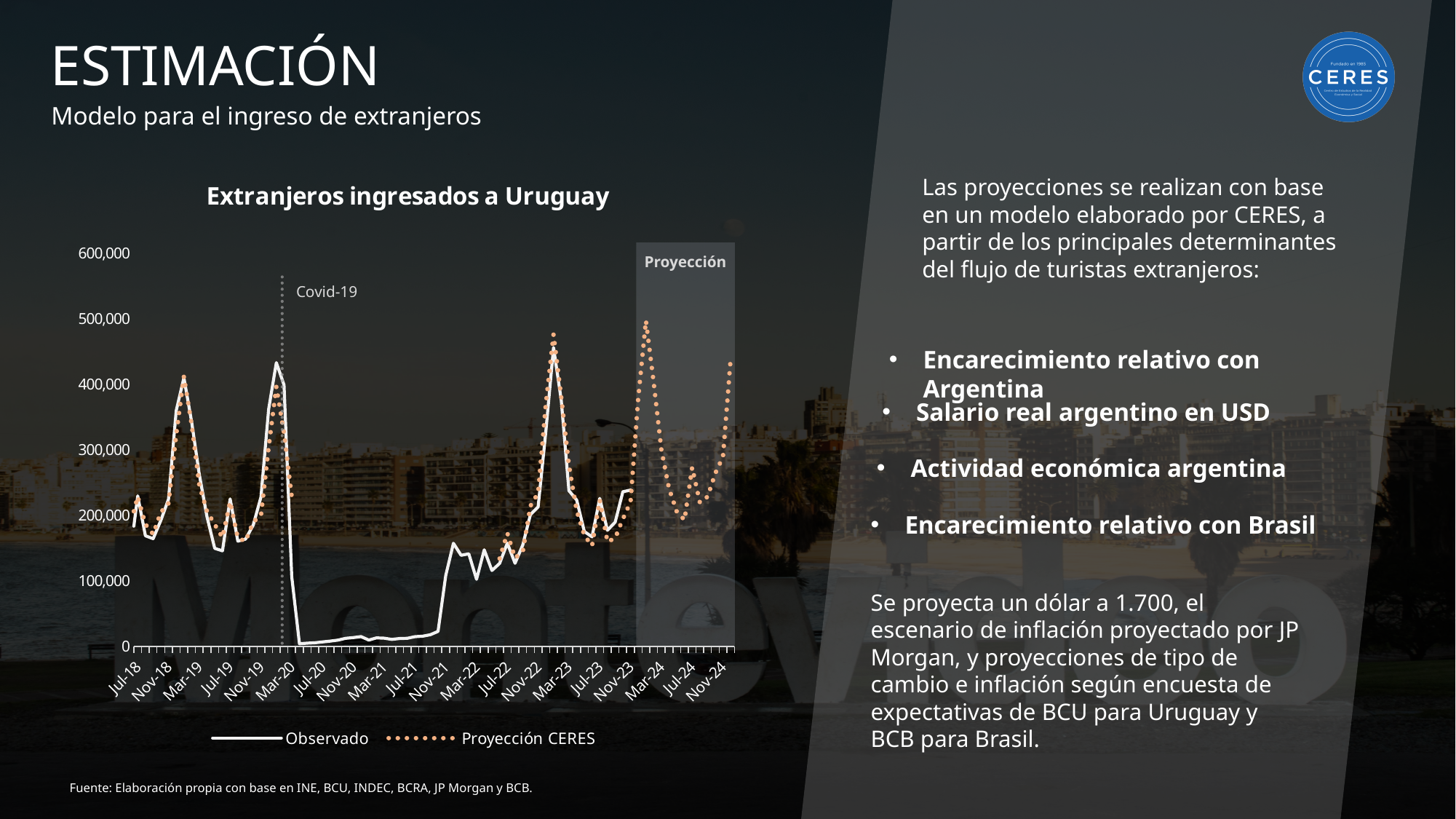
Does the Observado series rise or fall immediately after the Covid-19 marker at Mar-20? Falls What is the title of the chart on the slide? Extranjeros ingresados a Uruguay Is the peak of the Proyección CERES series in early 2024 greater or less than 400,000? greater How many month labels are shown along the x axis of the chart? 20 What is the highest value shown on the y axis of the chart? 600,000 How many series does the legend of the chart list? 2 What are the two series named in the chart legend? Observado and Proyección CERES Is the Observado value at Jan-20 (just before the Covid-19 line) greater or less than 300,000? greater Is the peak of the Observado series in early 2023 greater or less than 400,000? greater What kind of chart is 'Extranjeros ingresados a Uruguay'? Line chart